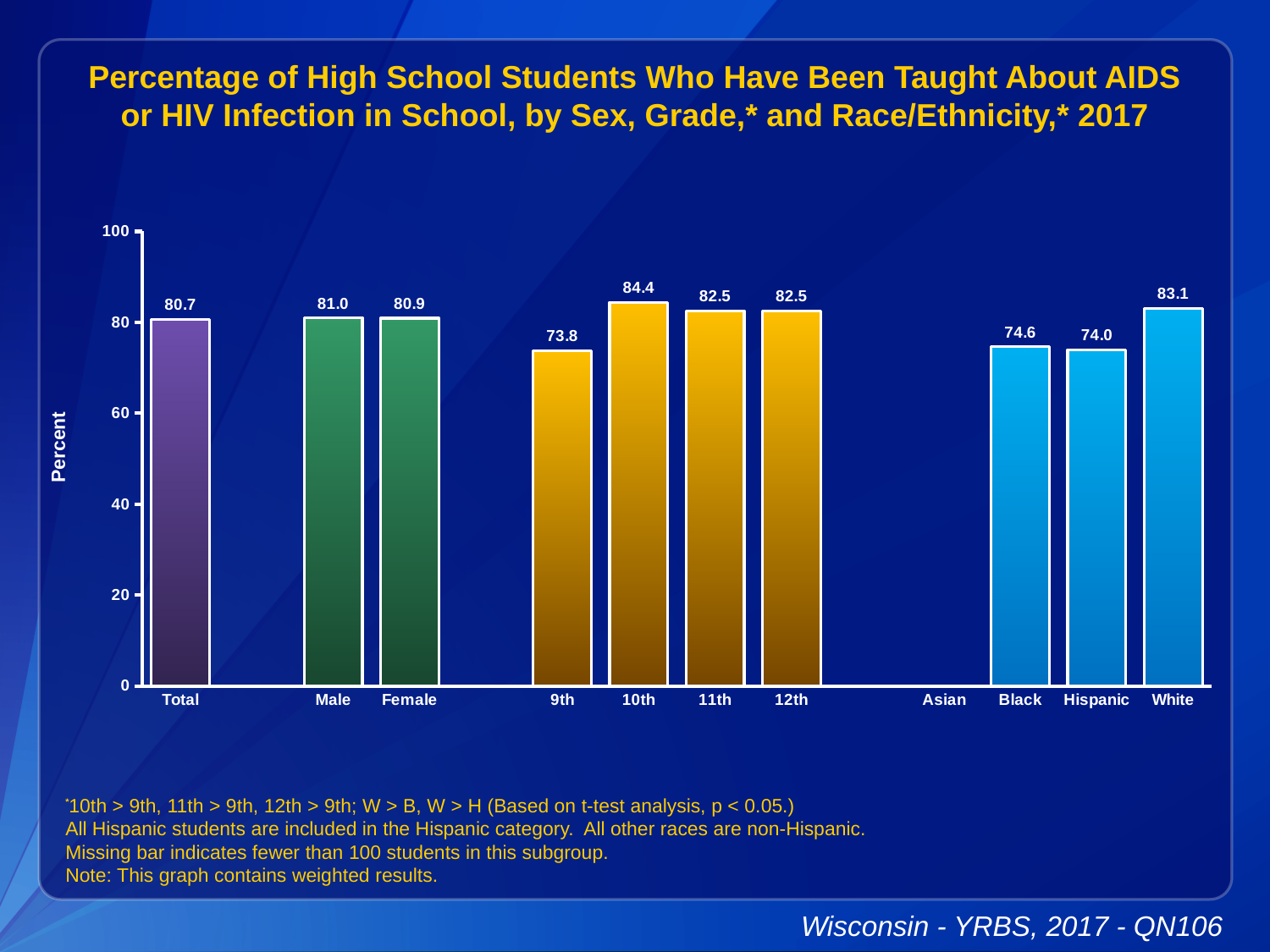
What is the value for Hispanic students? 74.0 Which category with a bar has the lowest value? 9th What is the value for 10th grade? 84.4 Is the value for 9th grade greater or less than 80? less Which is larger, the value for Male or the value for Female? Male What is the difference between the values for White and Black students? 8.5 What kind of chart is this? bar chart What is the label on the y axis? Percent How many category labels are shown on the x axis? 11 What is the value for Total? 80.7 Which category has the highest value? 10th Which category label has no bar shown? Asian